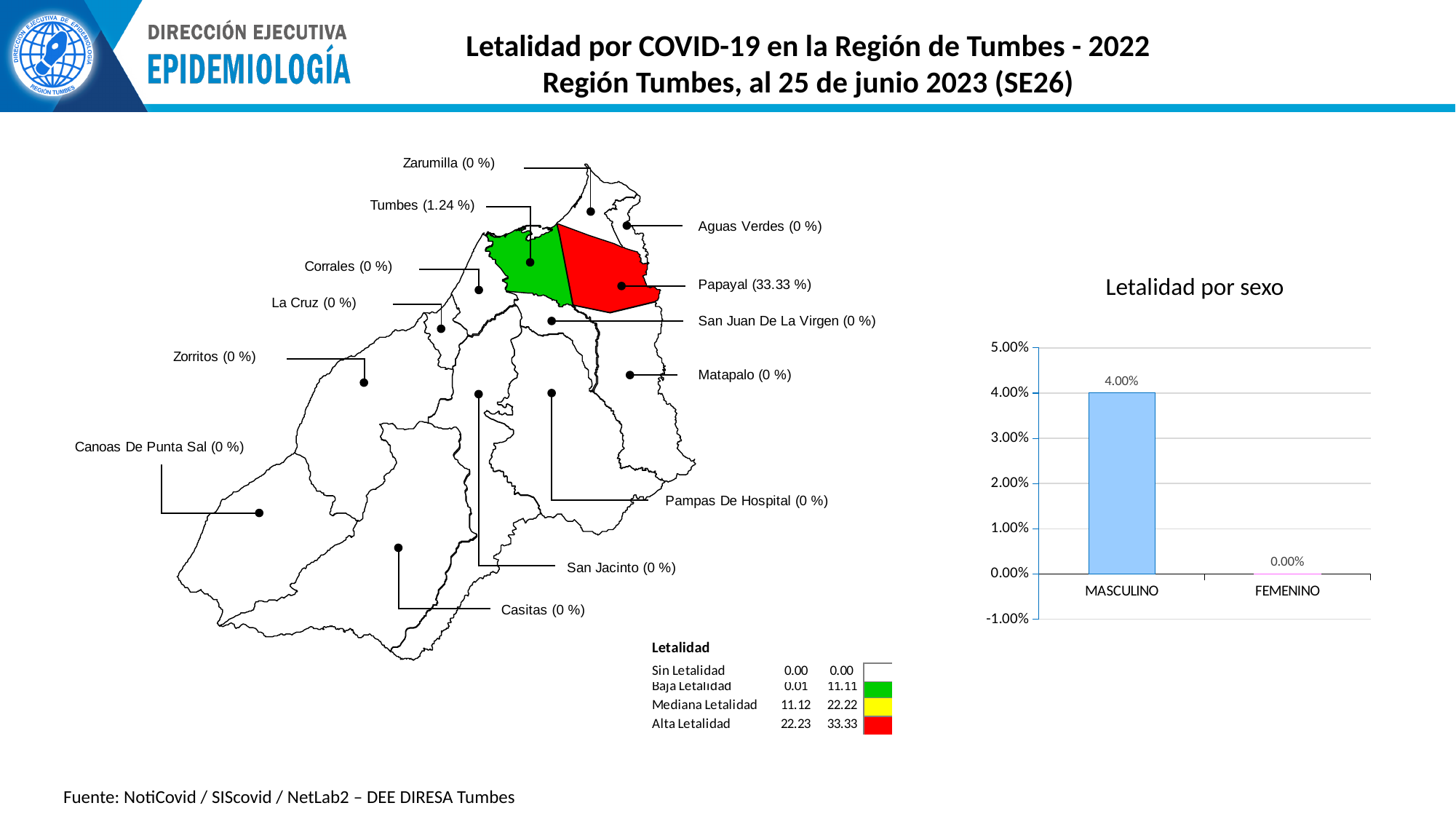
In the 'Letalidad por sexo' chart, what is the difference between the MASCULINO and FEMENINO values? 4.00% In the 'Letalidad por sexo' chart, which category has the lowest value? FEMENINO On the map, what lethality percentage is shown for Tumbes? 1.24 % In the 'Letalidad por sexo' chart, which is larger, MASCULINO or FEMENINO? MASCULINO In the 'Letalidad por sexo' chart, which category has the highest value? MASCULINO What kind of chart is 'Letalidad por sexo'? bar chart In the 'Letalidad por sexo' chart, what is the value for FEMENINO? 0.00% How many categories are shown in the 'Letalidad por sexo' chart? 2 In the 'Letalidad por sexo' chart, what is the value for MASCULINO? 4.00% On the map, what lethality percentage is shown for Papayal? 33.33 % In the 'Letalidad por sexo' chart, is the value for MASCULINO greater or less than 3.00%? greater What is the title of the chart on the right side of the slide? Letalidad por sexo